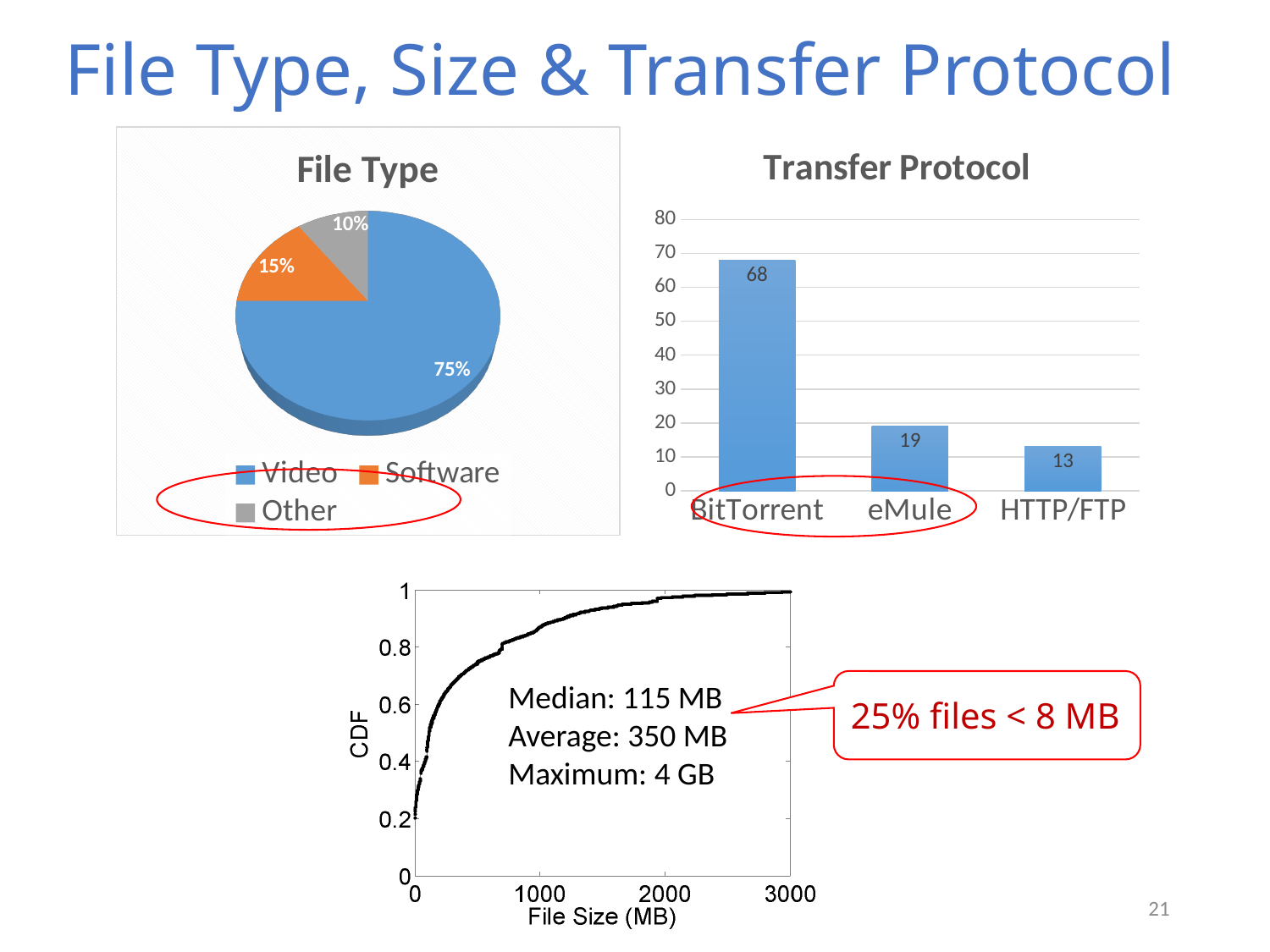
In the bottom CDF chart, does the CDF rise or fall as file size increases along the x axis? Rise What kind of chart is the Transfer Protocol chart? Bar chart In the File Type pie chart, what colour is the Software slice? Orange In the Transfer Protocol chart, what is the value for BitTorrent? 68 In the Transfer Protocol chart, what is the difference between the BitTorrent and eMule values? 49 In the File Type pie chart, what share of files are Video? 75% In the File Type pie chart, which file type has the smallest share? Other In the File Type pie chart, what share of files are Software? 15% In the Transfer Protocol chart, which protocol has the highest value? BitTorrent In the Transfer Protocol chart, what is the value for HTTP/FTP? 13 In the Transfer Protocol chart, which is larger, eMule or HTTP/FTP? eMule In the File Type pie chart, how many categories does the legend list? 3